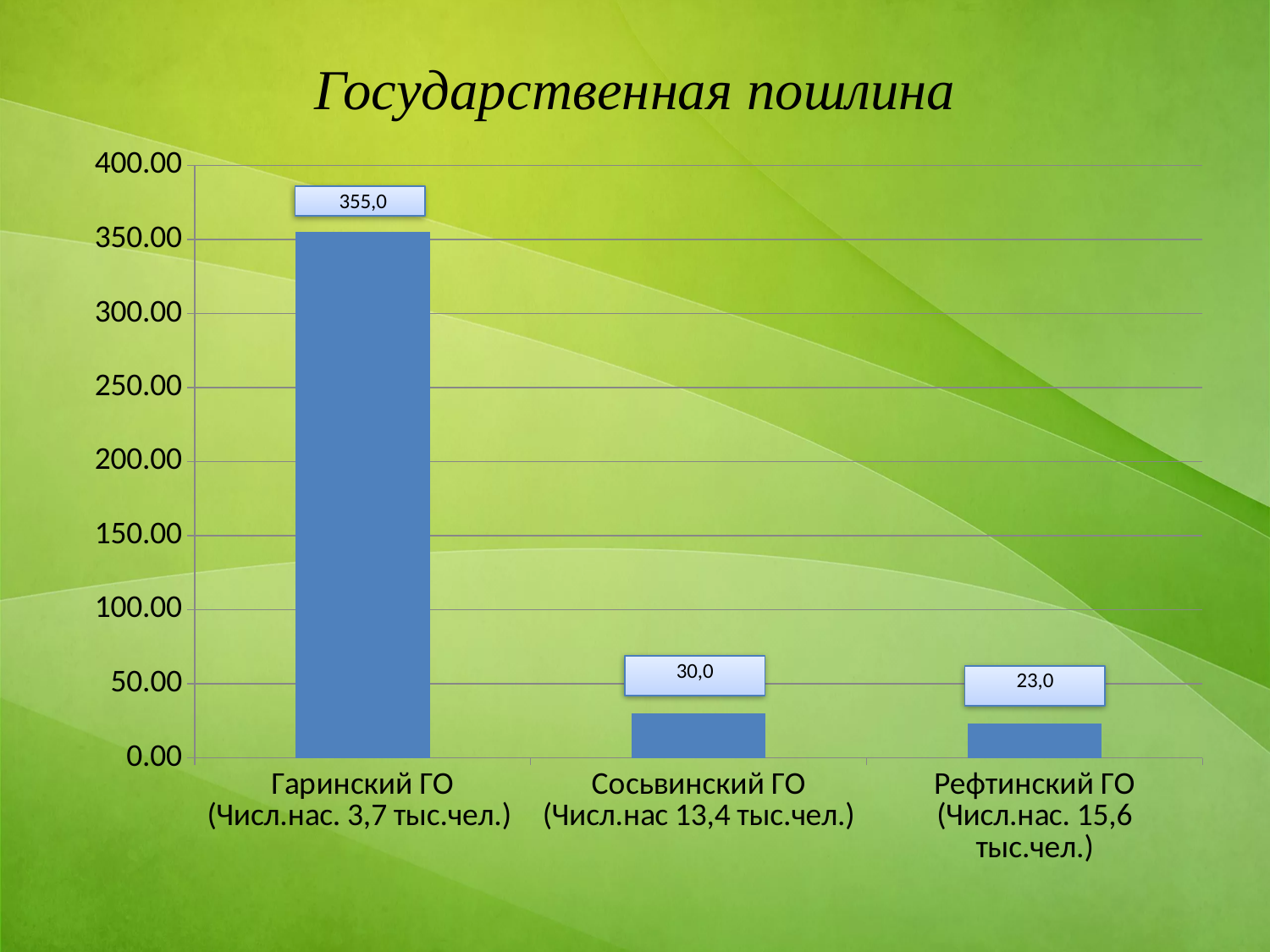
What is the value for Рефтинский ГО? 23,0 Is the value for Гаринский ГО greater or less than 300.00? greater Which category has the highest value? Гаринский ГО What kind of chart is shown on the slide? bar chart Which is larger, the value for Сосьвинский ГО or the value for Рефтинский ГО? Сосьвинский ГО What is the difference between the values for Гаринский ГО and Сосьвинский ГО? 325,0 How many categories are shown on the chart? 3 Which category has the lowest value? Рефтинский ГО What is the title of the chart? Государственная пошлина What is the value for Сосьвинский ГО? 30,0 What is the difference between the values for Сосьвинский ГО and Рефтинский ГО? 7,0 What is the value for Гаринский ГО? 355,0